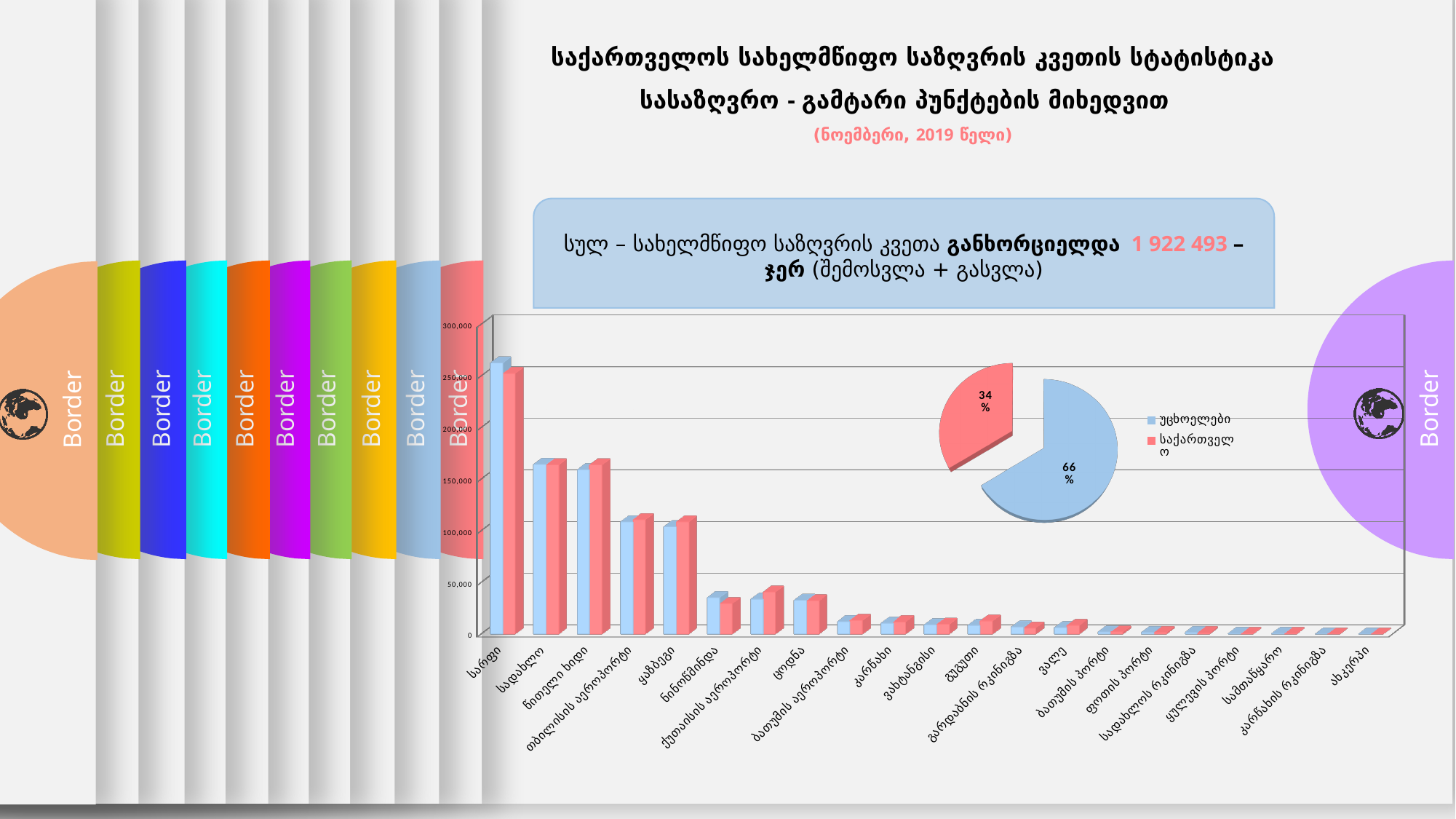
In the pie chart, what share does უცხოელები have? 66% In the bar chart, which is larger, the value for სადახლო or the value for ყაზბეგი? სადახლო In the bar chart, is the value for ნინოწმინდა greater or less than 50,000? less In the bar chart, which category has the highest values? სარფი In the pie chart, what share does საქართველო have? 34% Do the values in the bar chart generally rise or fall from left to right along the x axis? fall How many categories are shown on the x axis of the bar chart? 21 In the bar chart, is the value for თბილისის აეროპორტი greater or less than 150,000? less What kind of chart is the large chart on the left of the slide? bar chart What is the highest value shown on the vertical axis of the bar chart? 300,000 How many series does the legend list? 2